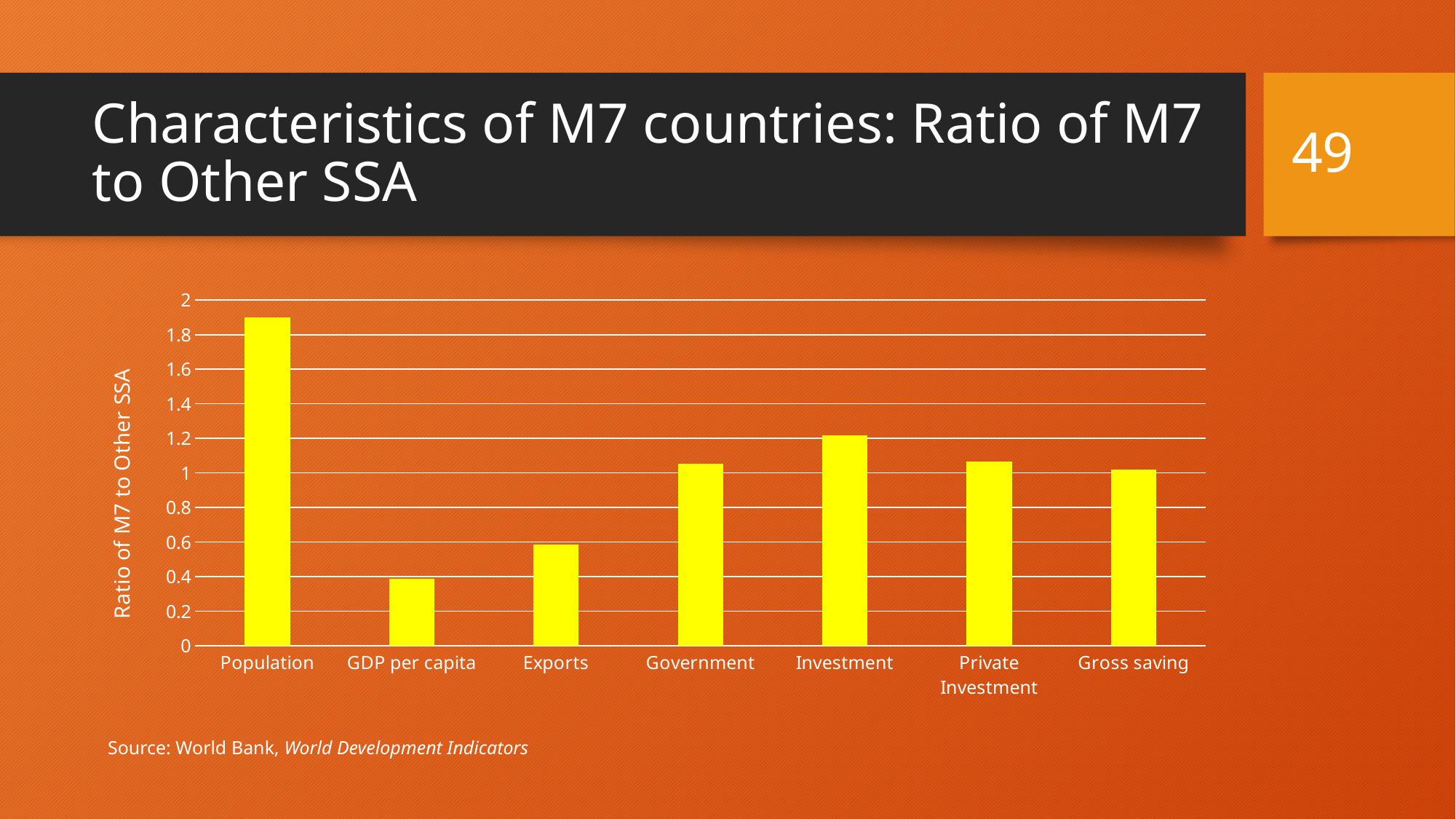
What is the label on the vertical axis of the chart? Ratio of M7 to Other SSA Is the value for Exports greater or less than 0.8? less How many categories are plotted on the x axis of the chart? 7 Which is larger, the value for Exports or the value for GDP per capita? Exports What kind of chart is shown on the slide? bar chart Which is larger, the value for Investment or the value for Government? Investment Is the value for Investment greater or less than 1? greater Which category has the lowest ratio of M7 to Other SSA? GDP per capita Is the value for GDP per capita greater or less than 0.6? less Which category has the highest ratio of M7 to Other SSA? Population What colour are the bars in the chart? yellow